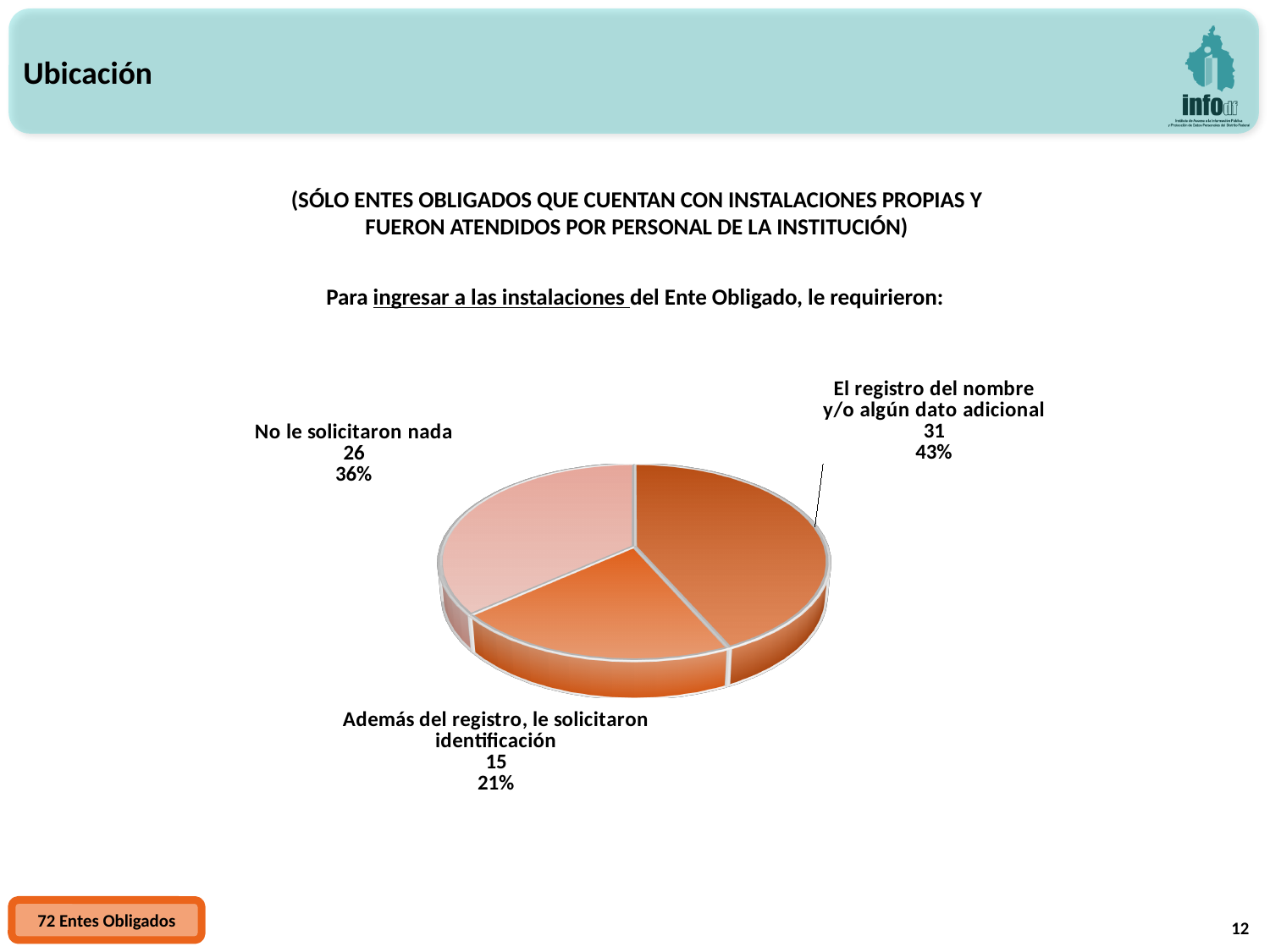
How many slices does the pie chart have? 3 What is the value for "No le solicitaron nada"? 26 What is the difference between the values for "El registro del nombre y/o algún dato adicional" and "No le solicitaron nada"? 5 What is the value for "El registro del nombre y/o algún dato adicional"? 31 Which category has the lowest value? Además del registro, le solicitaron identificación Which is larger: the value for "No le solicitaron nada" or for "Además del registro, le solicitaron identificación"? No le solicitaron nada What share of the pie does "Además del registro, le solicitaron identificación" represent? 21% What is the value for "Además del registro, le solicitaron identificación"? 15 What share of the pie does "No le solicitaron nada" represent? 36% What kind of chart is shown on the slide? pie chart Which category has the highest value? El registro del nombre y/o algún dato adicional What is the total of the three slice values in the pie chart? 72